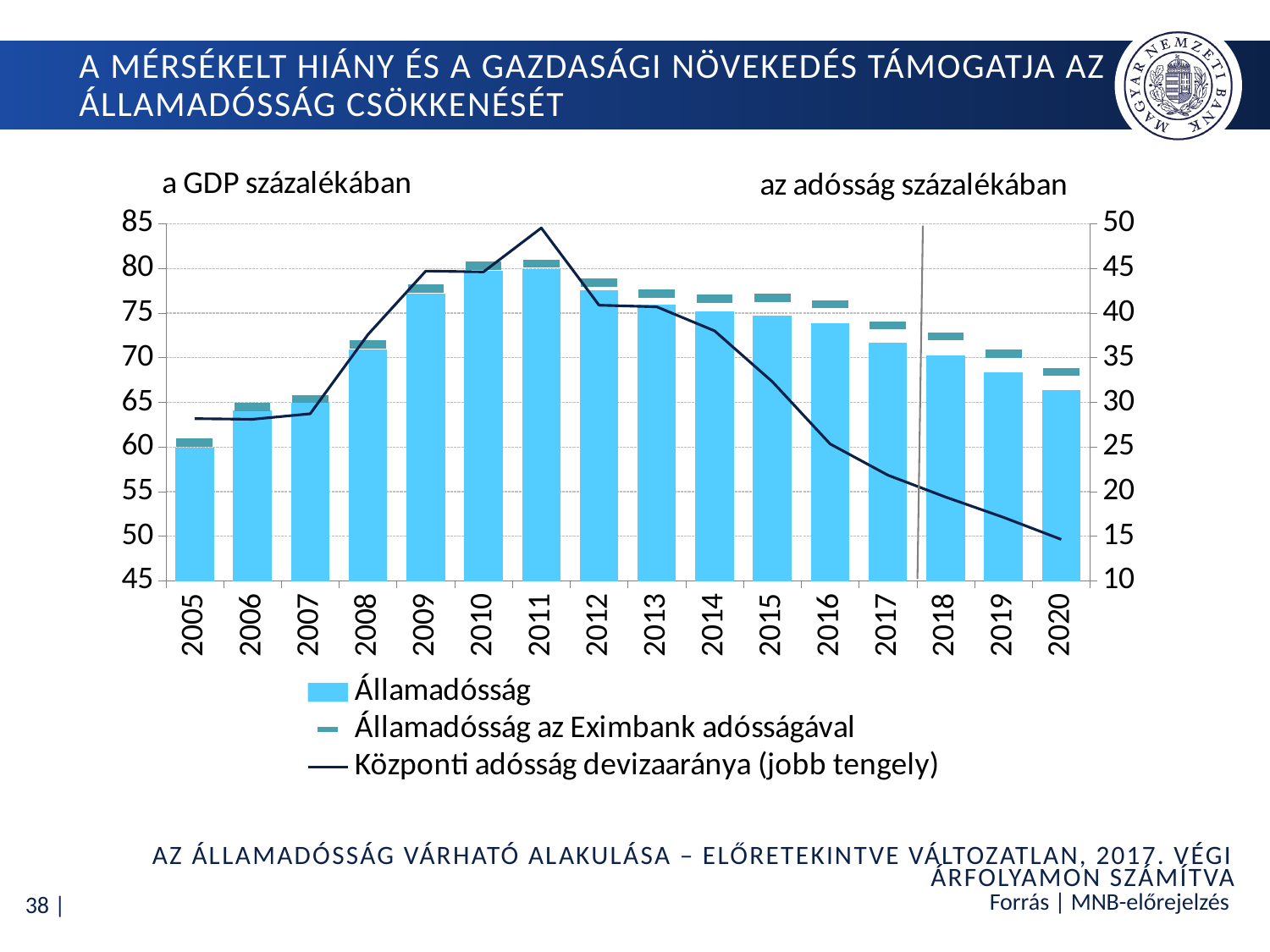
What is the label above the right-hand axis of the chart? az adósság százalékában Which year has the lowest Államadósság bar? 2005 Is the Központi adósság devizaaránya value for 2020 greater or less than 20 on the right axis? less Which year has the larger Államadósság bar, 2009 or 2006? 2009 In which year does the Központi adósság devizaaránya line reach its highest point? 2011 Do the Államadósság bars rise or fall from 2011 to 2020? fall How many series does the chart legend list? 3 How many years are shown on the x axis of the chart? 16 What kind of chart is shown on the slide? A bar chart combined with a line Is the Államadósság value for 2020 greater or less than 70? less Is the Államadósság value for 2005 greater or less than 65? less